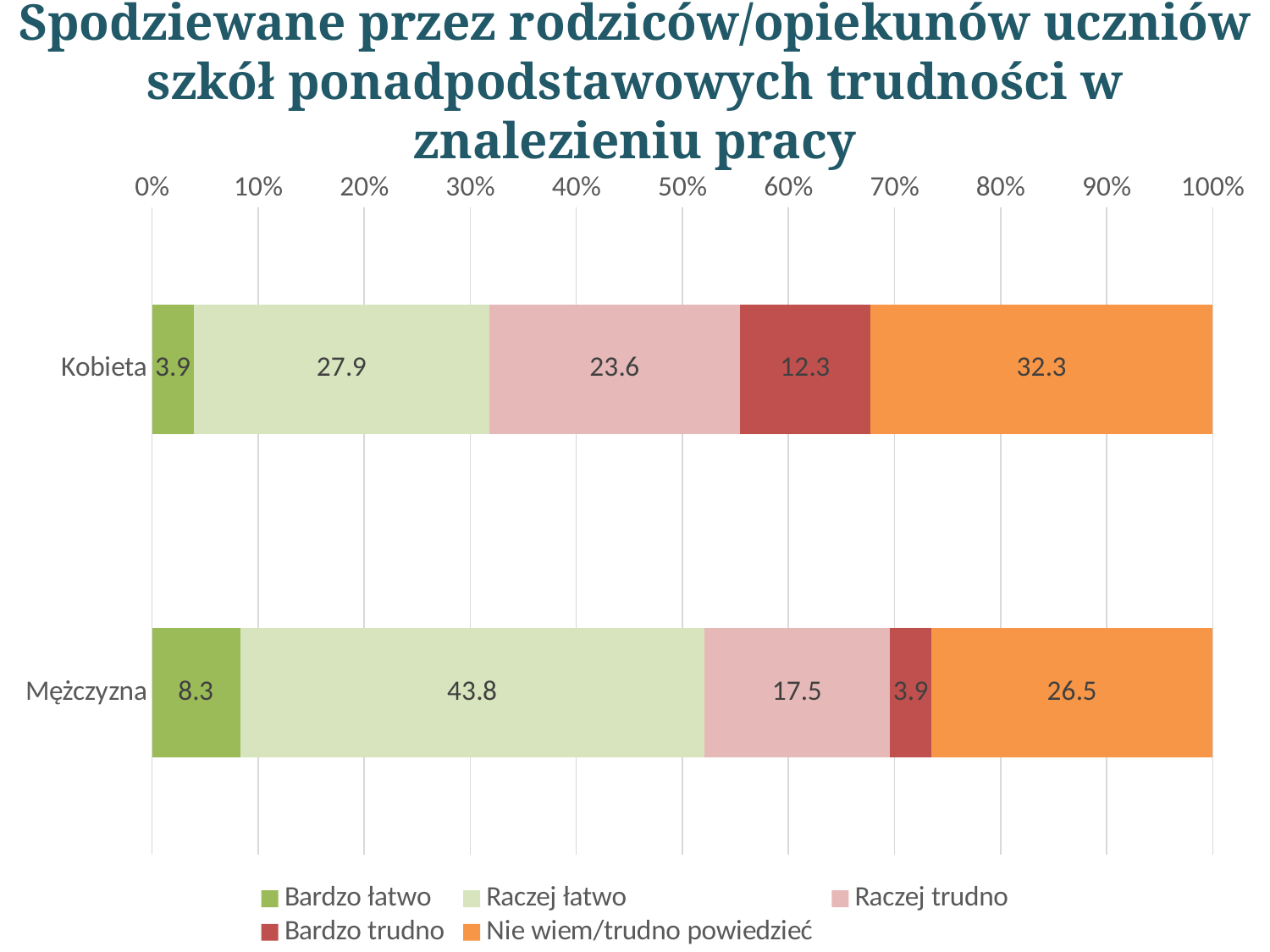
What colour represents "Nie wiem/trudno powiedzieć" in the chart? Orange What is the value for "Nie wiem/trudno powiedzieć" for Mężczyzna? 26.5 What is the difference between the "Raczej łatwo" values for Mężczyzna and Kobieta? 15.9 What kind of chart is shown on the slide? Stacked bar chart Which series has the smallest value in the Kobieta bar? Bardzo łatwo Which series has the largest value in the Mężczyzna bar? Raczej łatwo How many categories are shown on the y axis? 2 Which category has the larger value for "Raczej trudno", Kobieta or Mężczyzna? Kobieta How many series does the legend list? 5 What is the value for "Bardzo łatwo" for Mężczyzna? 8.3 What is the value for "Raczej łatwo" for Kobieta? 27.9 What is the value for "Bardzo trudno" for Kobieta? 12.3